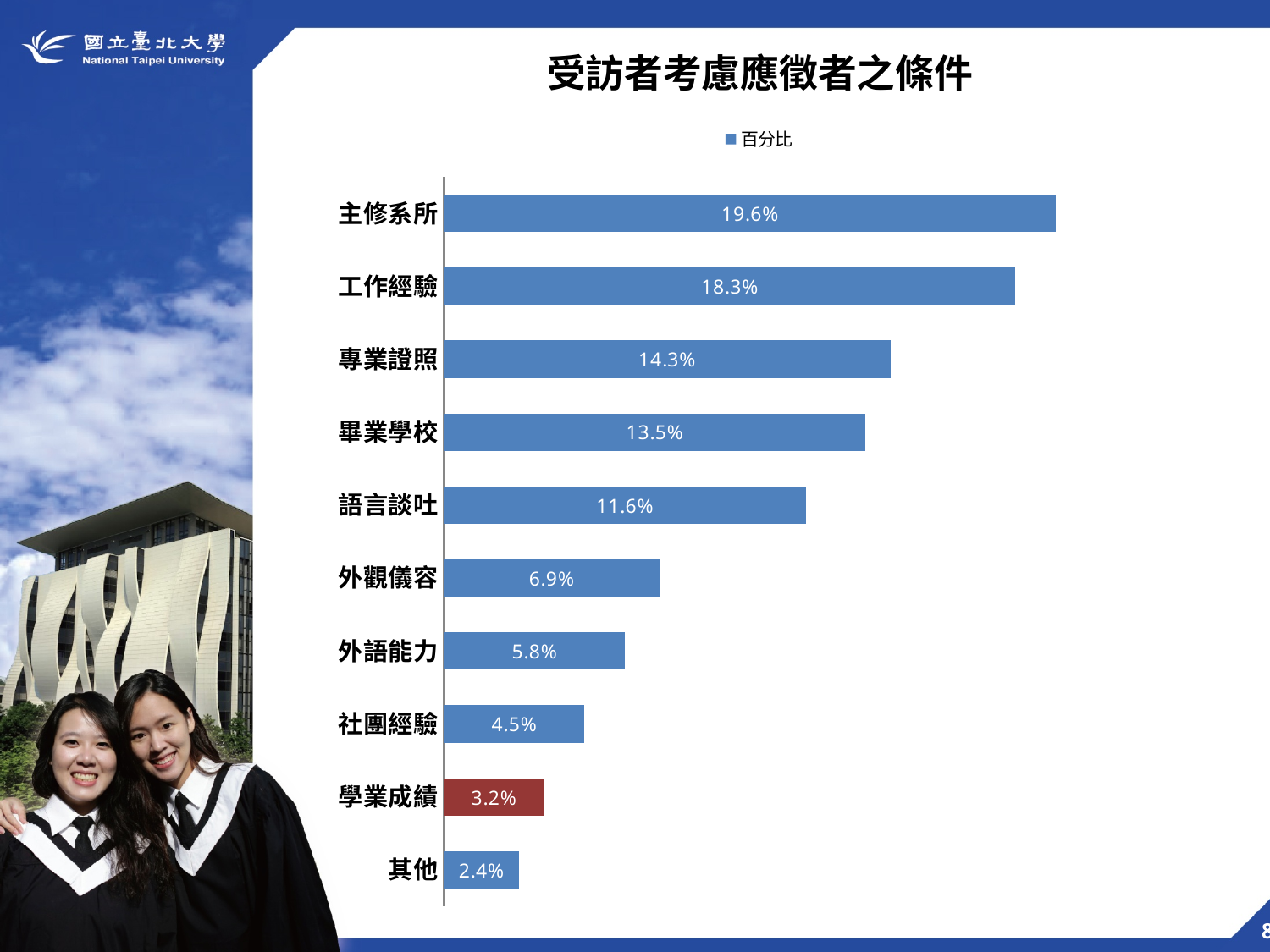
What is the value for 語言談吐? 11.6% What is the value for 學業成績? 3.2% Which is larger, the value for 外觀儀容 or the value for 外語能力? 外觀儀容 How many series does the legend list? 1 What is the difference between the values for 主修系所 and 工作經驗? 1.3% What is the value for 主修系所? 19.6% Which category has the lowest value? 其他 What is the difference between the values for 專業證照 and 畢業學校? 0.8% Which category's bar is coloured red instead of blue? 學業成績 Which category has the highest value? 主修系所 How many categories are shown in the chart? 10 What type of chart is shown on the slide? Bar chart